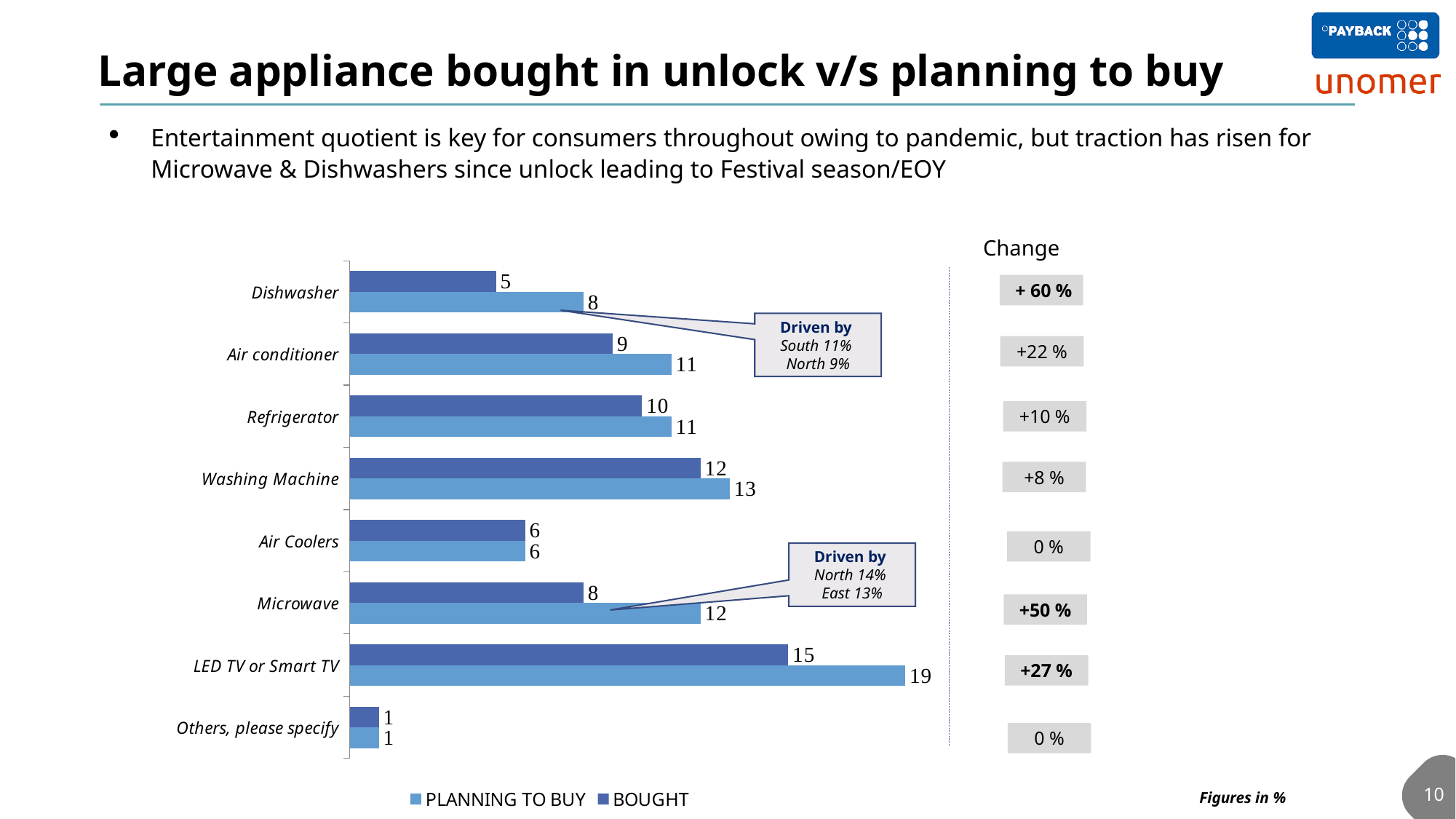
How many series does the legend list? 2 Which category has the highest BOUGHT value? LED TV or Smart TV What kind of chart is shown on the slide? Bar chart What is the PLANNING TO BUY value for Dishwasher? 8 What is the difference between the PLANNING TO BUY and BOUGHT values for Microwave? 4 What is the PLANNING TO BUY value for LED TV or Smart TV? 19 Which category has the lowest PLANNING TO BUY value? Others, please specify Which is larger for Air conditioner: the PLANNING TO BUY value or the BOUGHT value? PLANNING TO BUY How many categories are shown on the chart? 8 What is the BOUGHT value for Microwave? 8 Which series is shown in the darker blue colour? BOUGHT What is the Change value shown for Dishwasher? + 60 %